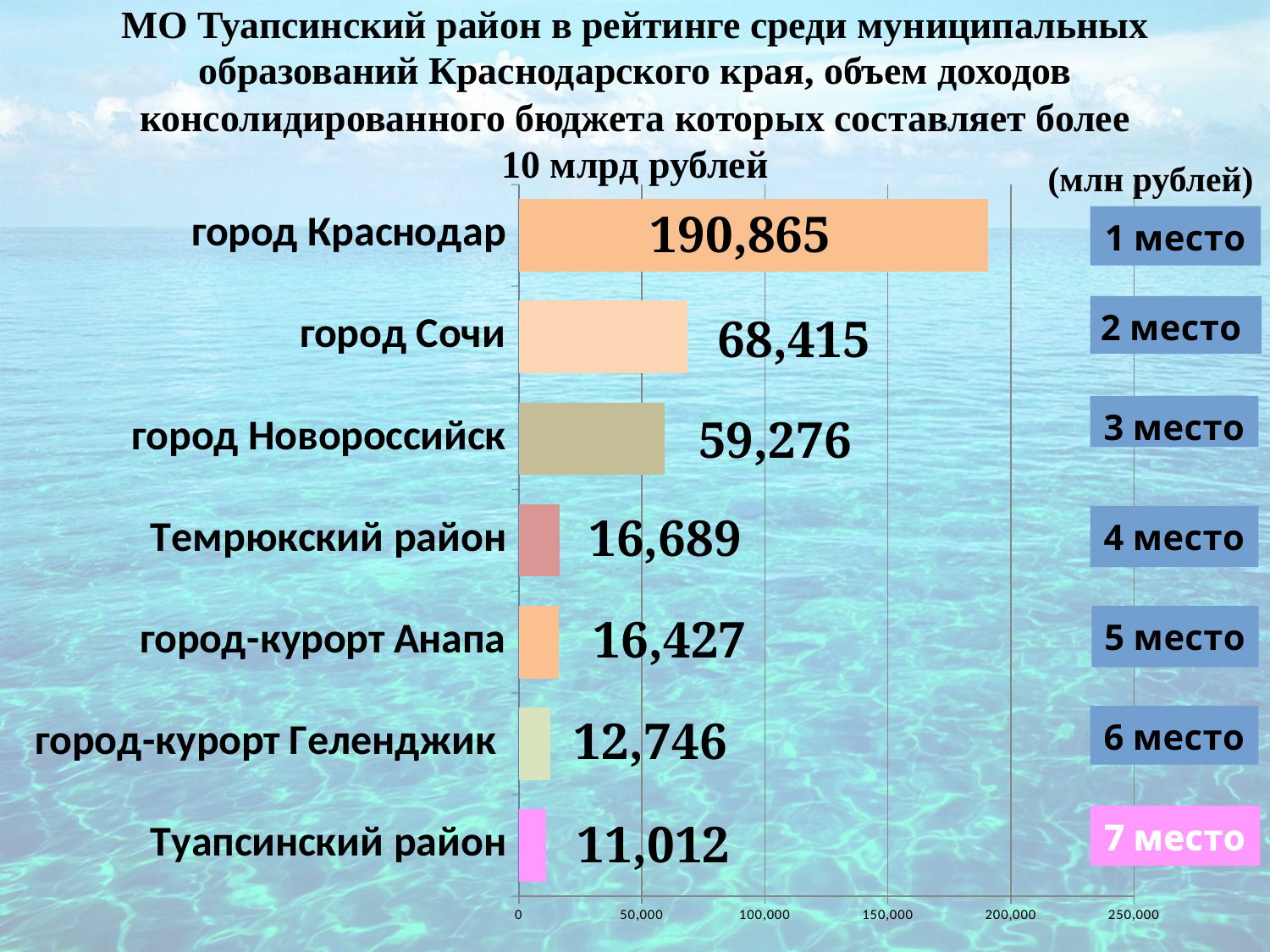
What is the difference between the values for город Краснодар and Туапсинский район? 179,853 What is the value for город Новороссийск? 59,276 What is the difference between the values for город Сочи and город Новороссийск? 9,139 Which category has the lowest value? Туапсинский район How many categories are shown in the chart? 7 What is the value for Туапсинский район? 11,012 Which is larger, the value for Темрюкский район or the value for город-курорт Анапа? Темрюкский район What rank label is shown next to Туапсинский район? 7 место Is the value for город Сочи greater or less than 50,000? greater Which category has the highest value? город Краснодар What kind of chart is shown on the slide? bar chart What is the value for город Краснодар? 190,865